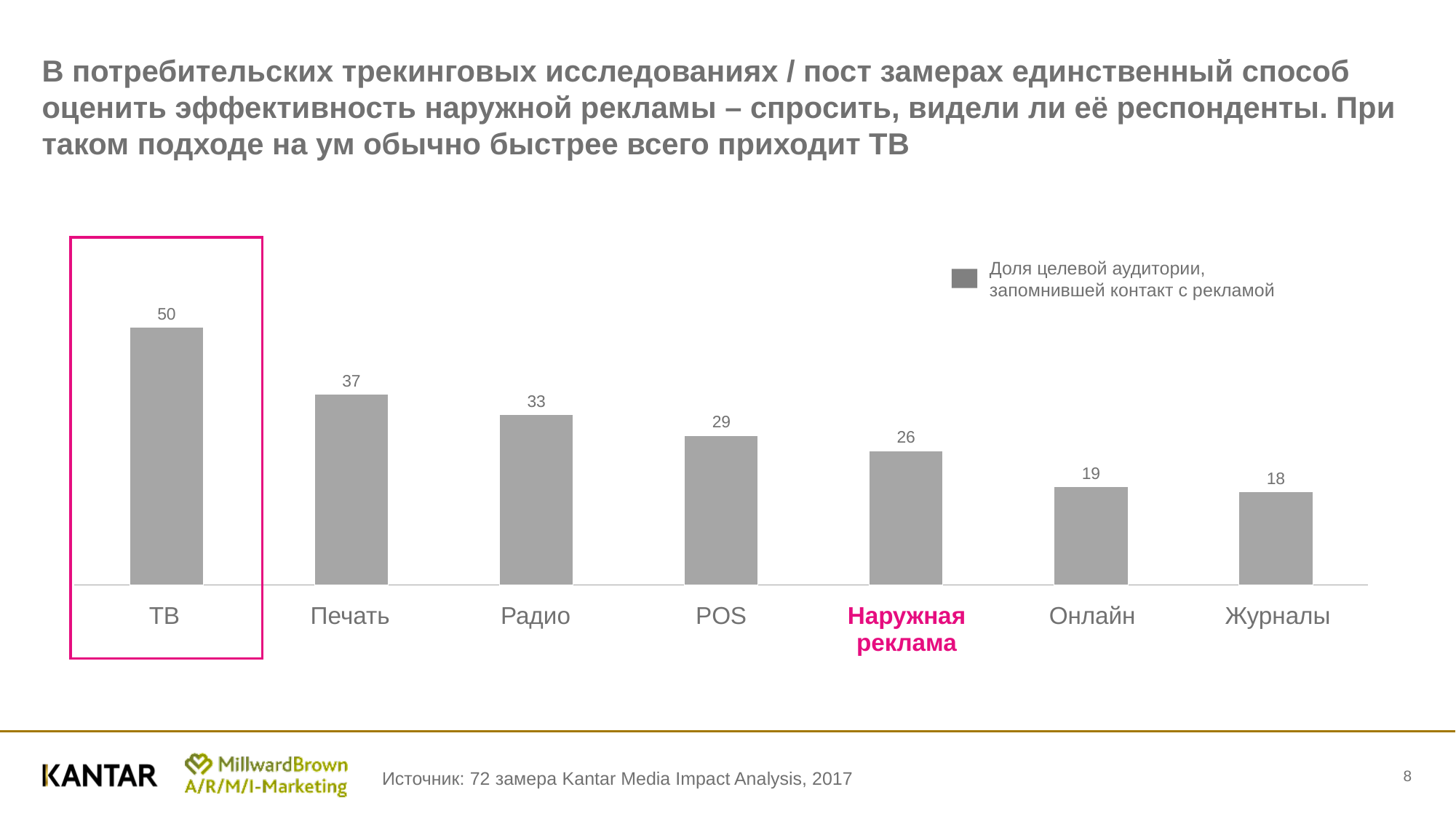
What is the difference between the values for ТВ and Наружная реклама? 24 What is the value for Наружная реклама? 26 Which category has the lowest value? Журналы Do the values rise or fall from left to right along the x axis? fall Which category has the highest value? ТВ What is the value for Радио? 33 What kind of chart is shown on the slide? bar chart How many categories are shown on the x axis? 7 How many series does the legend list? 1 Which is larger, the value for POS or the value for Онлайн? POS What is the difference between the values for Печать and Онлайн? 18 What is the value for ТВ? 50